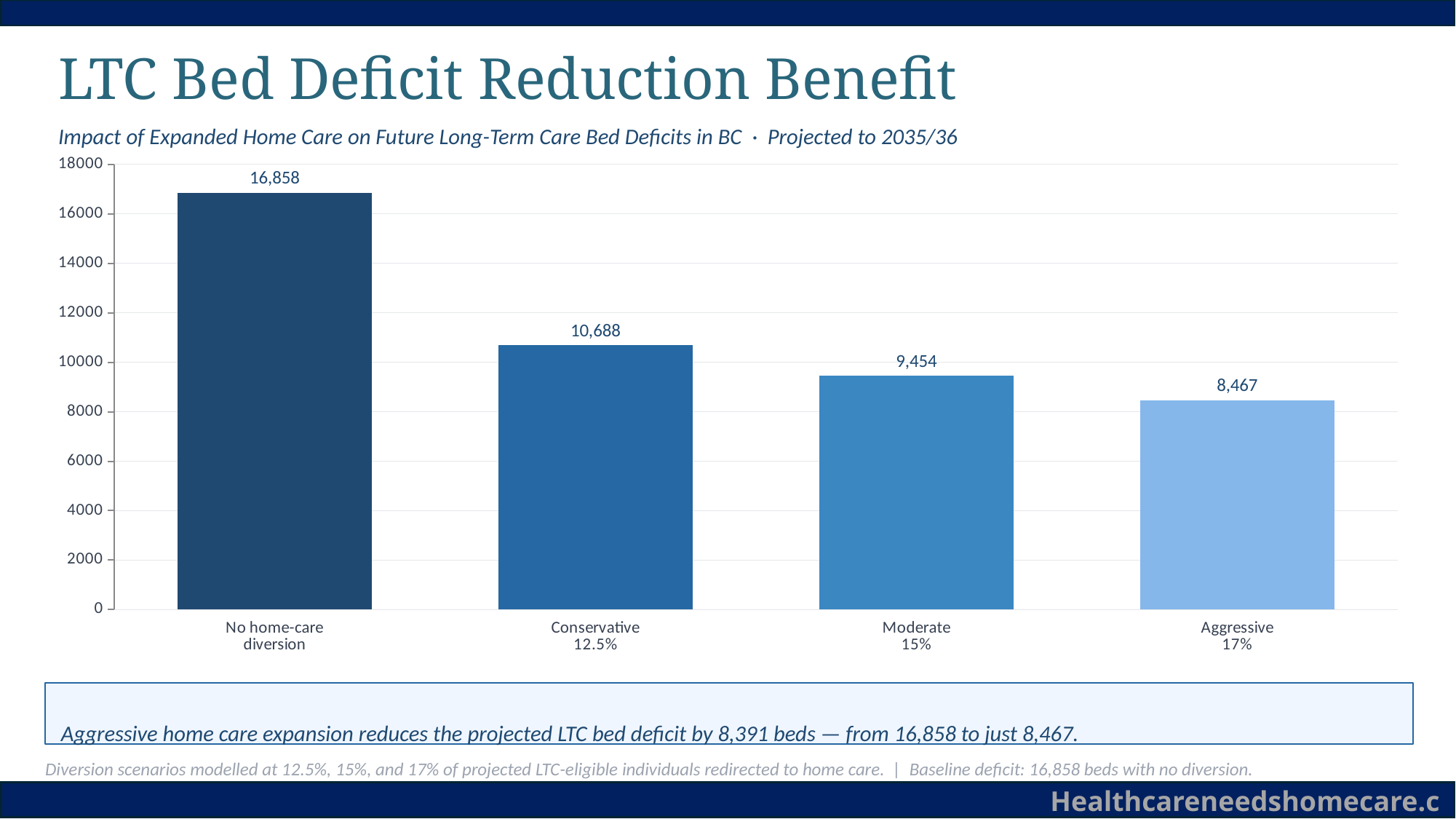
What is the difference in bed deficit between the Conservative 12.5% and Moderate 15% scenarios? 1,234 What is the projected bed deficit under the Moderate 15% scenario? 9,454 Which scenario has the highest projected bed deficit? No home-care diversion What is the difference in bed deficit between the no home-care diversion scenario and the Aggressive 17% scenario? 8,391 What is the projected bed deficit under the Aggressive 17% scenario? 8,467 Which scenario has the lowest projected bed deficit? Aggressive 17% Do the bed deficit values rise or fall from left to right across the scenarios? Fall What is the projected bed deficit under the Conservative 12.5% scenario? 10,688 What type of chart is shown on the slide? Bar chart How many scenarios are shown in the chart? 4 What is the projected LTC bed deficit with no home-care diversion? 16,858 Which has a larger bed deficit, the Moderate 15% scenario or the Aggressive 17% scenario? Moderate 15%